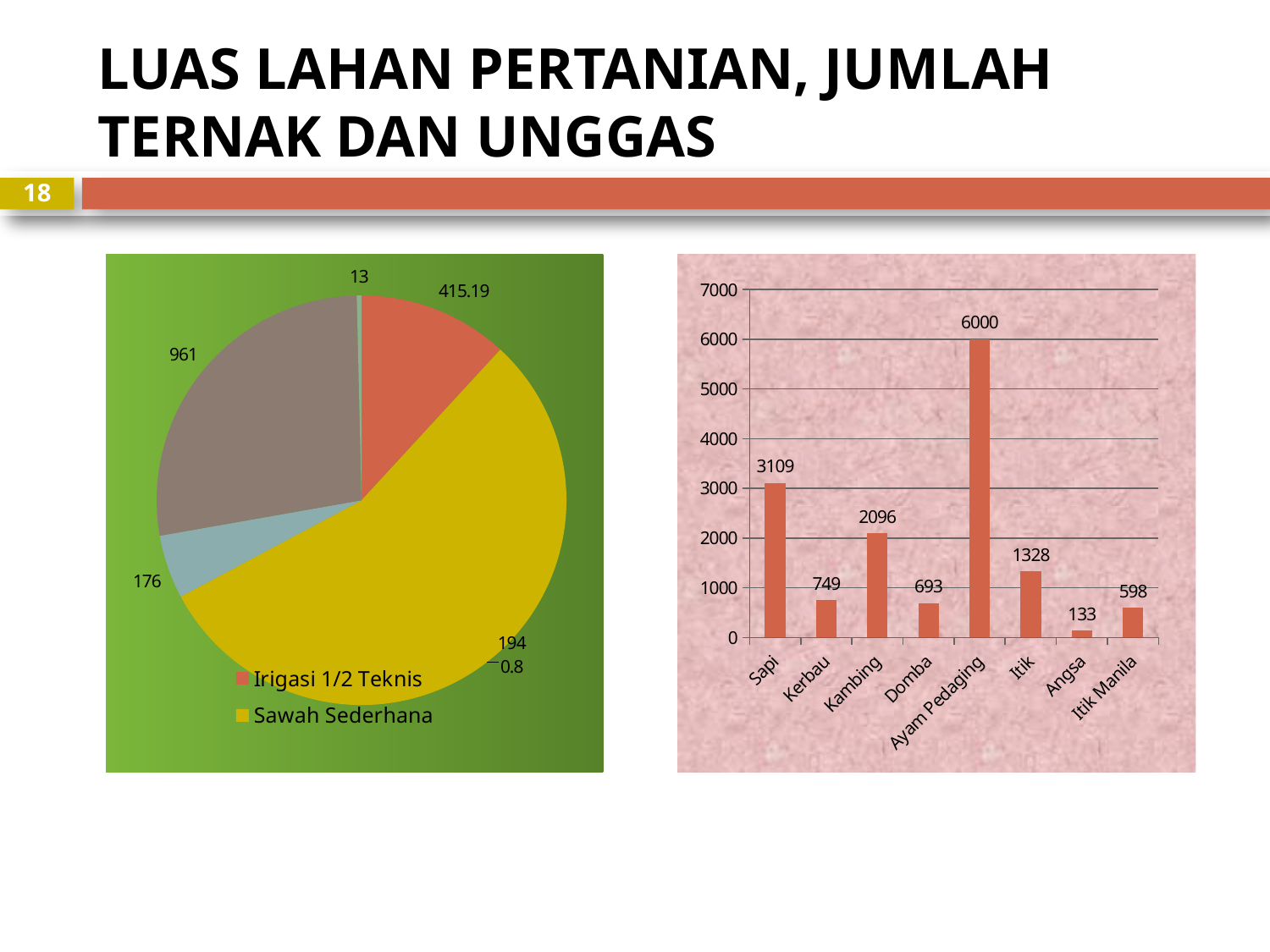
In the bar chart on the right, what is the value for Itik Manila? 598 What kind of chart is the chart on the left of the slide? Pie chart In the bar chart on the right, what is the value for Ayam Pedaging? 6000 In the bar chart on the right, what is the value for Angsa? 133 In the bar chart on the right, is the value for Domba greater or less than 1000? less In the bar chart on the right, which category has the lowest value? Angsa How many categories are shown in the bar chart on the right? 8 What are the two legend entries shown in the pie chart on the left? Irigasi 1/2 Teknis and Sawah Sederhana In the bar chart on the right, what is the difference between the values for Sapi and Kambing? 1013 In the bar chart on the right, which is larger, the value for Itik or the value for Kerbau? Itik In the bar chart on the right, what is the value for Sapi? 3109 In the bar chart on the right, which category has the highest value? Ayam Pedaging